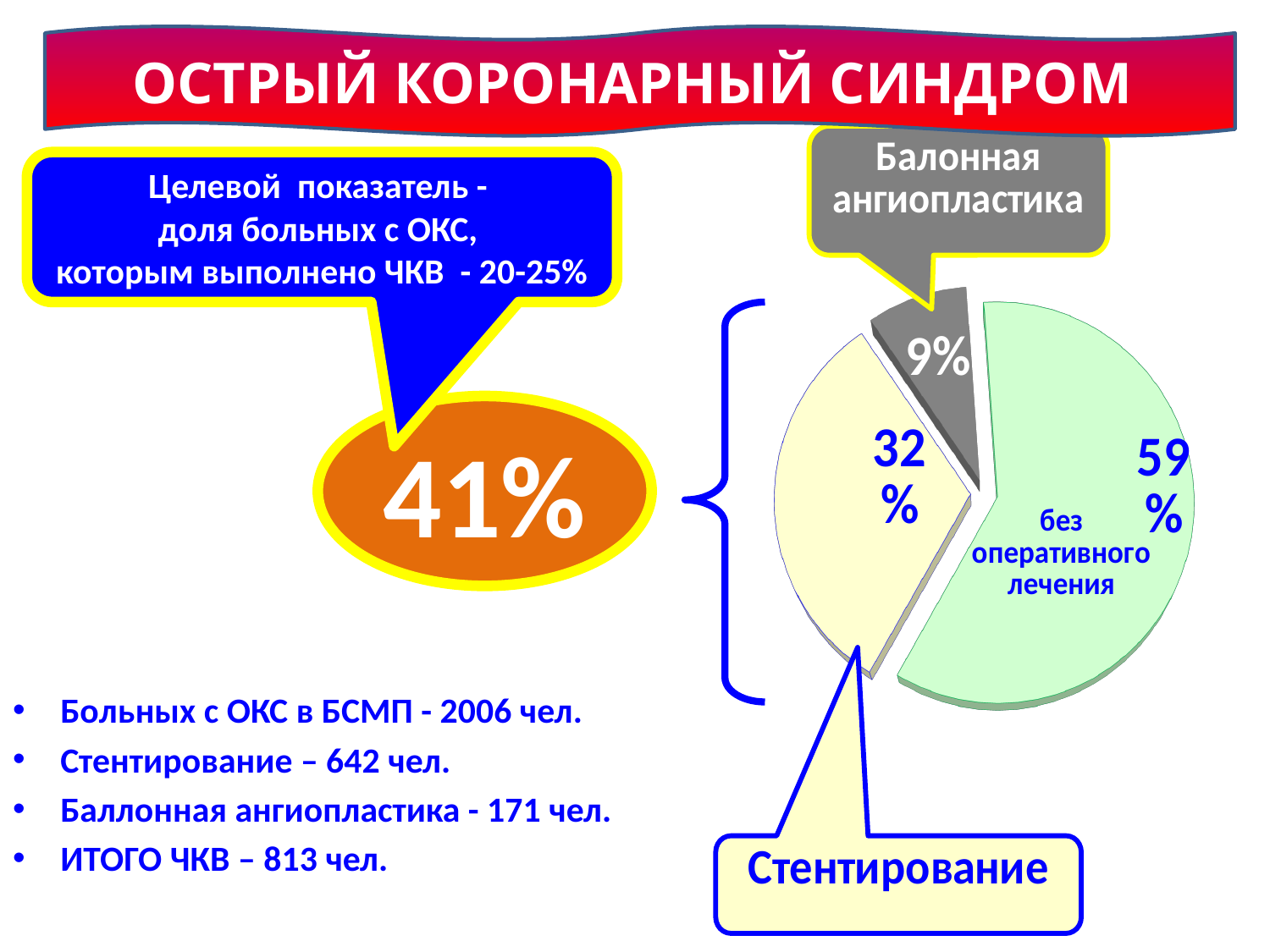
What colour is the "без оперативного лечения" slice of the pie chart? light green What share of the pie corresponds to "Стентирование"? 32% What colour is the "Балонная ангиопластика" slice of the pie chart? grey What share of the pie is labelled "без оперативного лечения"? 59% What is the combined share of the "Стентирование" and "Балонная ангиопластика" slices? 41% What is the difference between the "без оперативного лечения" share and the "Стентирование" share? 27% What share of the pie corresponds to "Балонная ангиопластика"? 9% How many slices does the pie chart have? 3 Which slice of the pie chart is the largest? без оперативного лечения Which is larger in the pie chart: the "Стентирование" slice or the "Балонная ангиопластика" slice? Стентирование Which slice of the pie chart is the smallest? Балонная ангиопластика What kind of chart is shown on the slide? pie chart